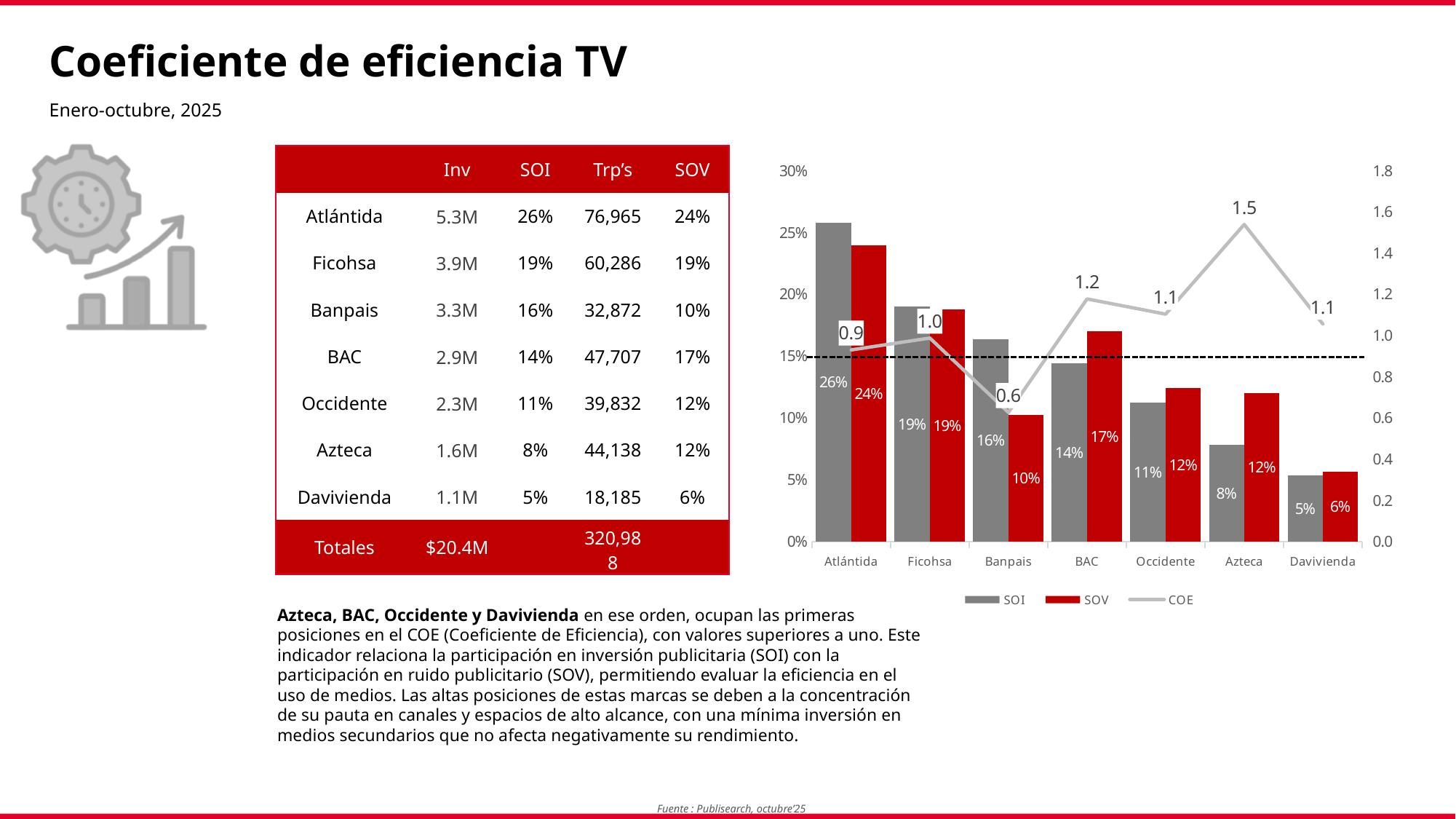
Which category has the highest COE value? Azteca What is the difference between the SOI and SOV values for Banpais? 6% Which series is plotted as a line in the chart? COE What is the SOI value for Atlántida? 26% Do the SOI values rise or fall from Atlántida to Davivienda? Fall Which is larger for Occidente, SOI or SOV? SOV How many series does the legend list? 3 Which category has the lowest SOV value? Davivienda What is the SOV value for BAC? 17% What is the COE value for Azteca? 1.5 What kind of chart is shown on the slide? Combined bar and line chart How many categories are shown on the x axis? 7